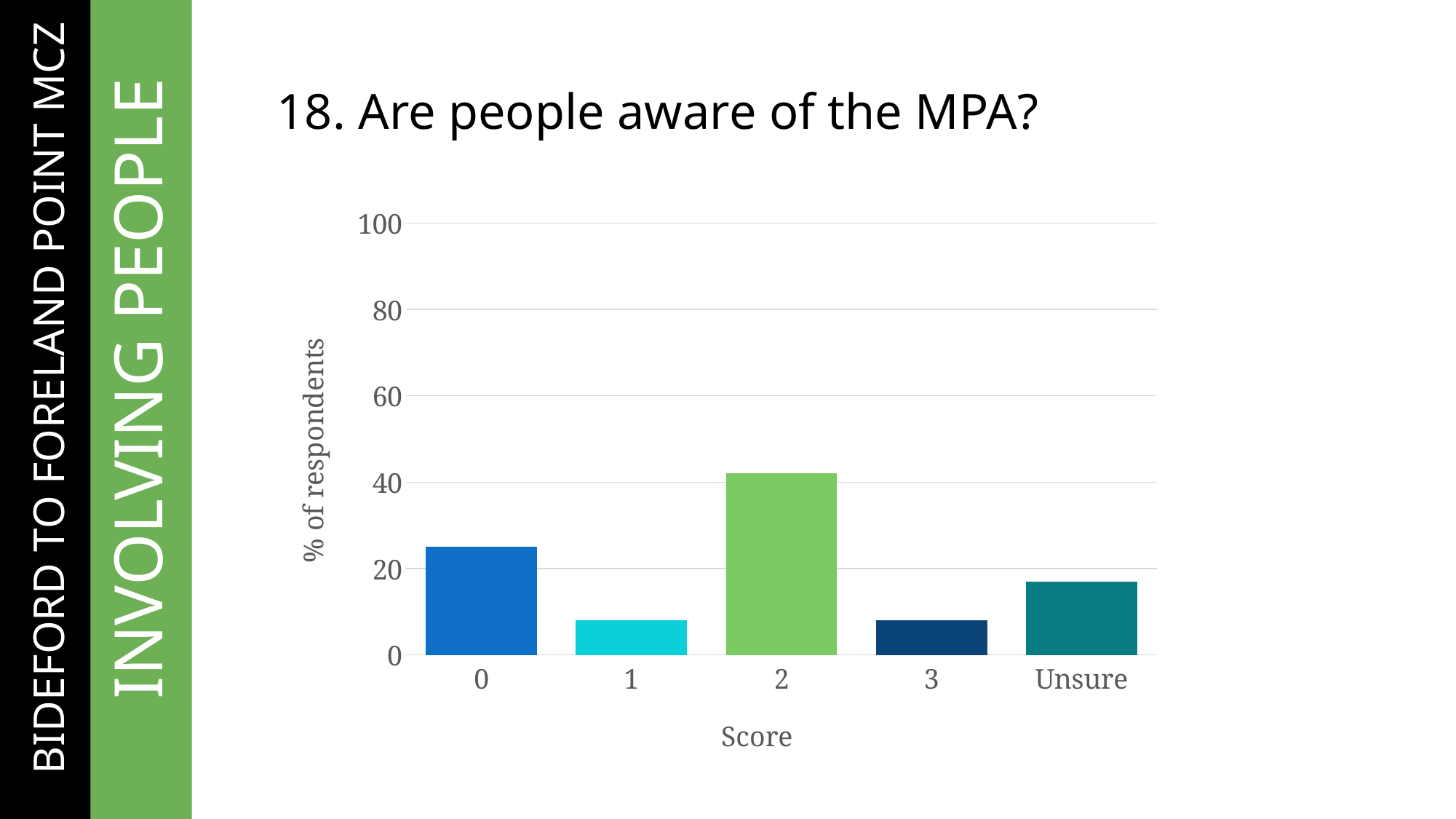
How many score categories are shown on the x axis? 5 What is the label of the y axis? % of respondents What is the title of the slide above the chart? 18. Are people aware of the MPA? What kind of chart is shown on the slide? bar chart Is the value for score 1 greater or less than 20? less Is the value for Unsure greater or less than 20? less Is the value for score 2 greater or less than 60? less Which has a higher percentage of respondents, score 2 or score 0? 2 Which has a higher percentage of respondents, score 0 or Unsure? 0 Which score category has the highest percentage of respondents? 2